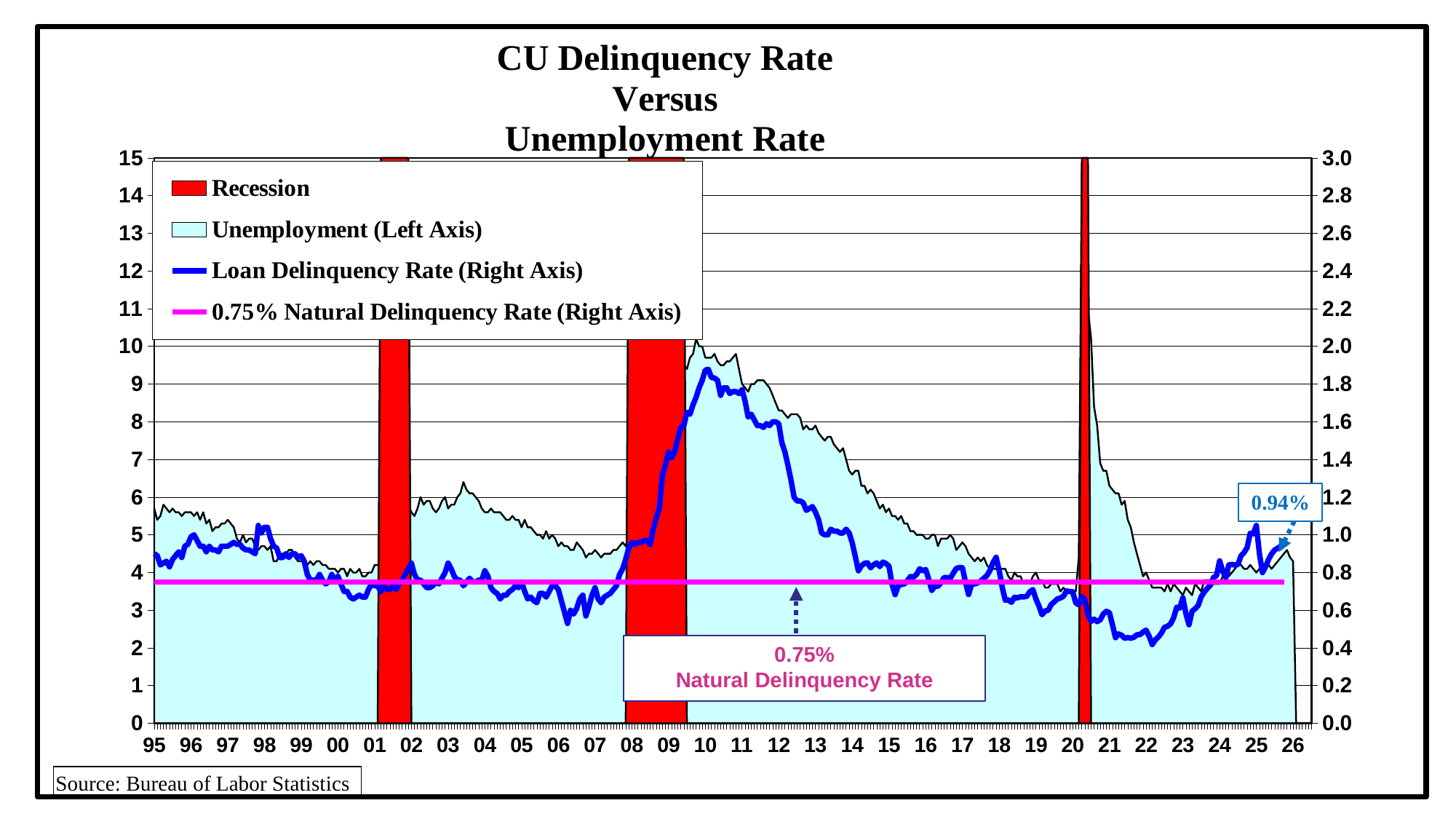
What is the most recent Loan Delinquency Rate value labeled on the chart? 0.94% How many Recession periods are shaded on the chart? 3 What value is the Natural Delinquency Rate line set at? 0.75% What source is cited for the chart? Bureau of Labor Statistics Does the Loan Delinquency Rate rise or fall from 10 to 14? fall Which is higher, the Loan Delinquency Rate around 10 or around 22? around 10 Is the Unemployment value around 19 greater or less than 5 on the left axis? less Is the Loan Delinquency Rate around 22 greater or less than 0.6 on the right axis? less Is the Unemployment value around 10 greater or less than 8 on the left axis? greater In which year on the x axis does Unemployment reach its highest peak? 20 How many entries does the chart's legend list? 4 What is the title of the chart? CU Delinquency Rate Versus Unemployment Rate